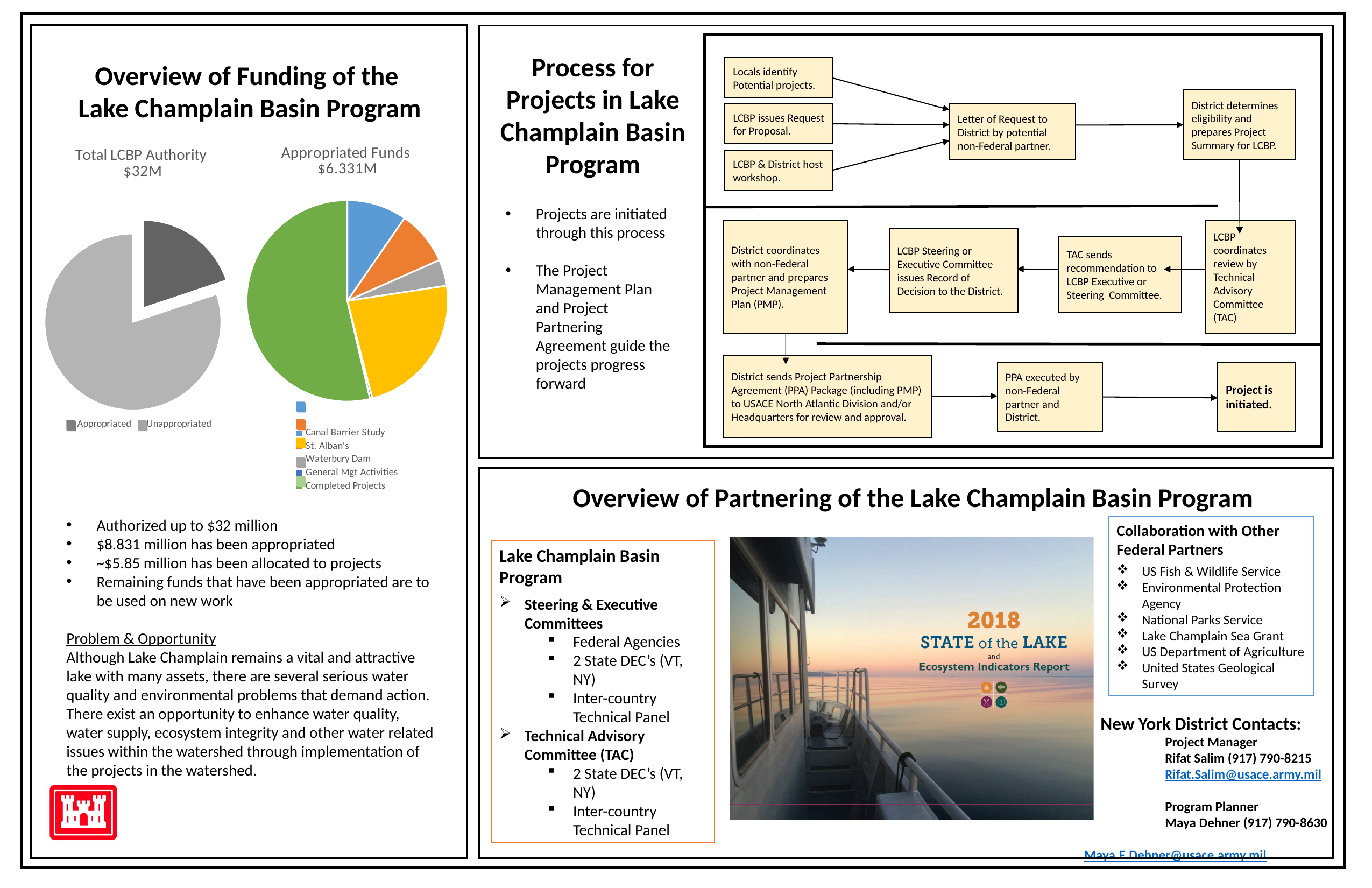
In the "Total LCBP Authority $32M" chart, which slice is larger, Appropriated or Unappropriated? Unappropriated In the "Appropriated Funds $6.331M" chart, which category has the largest slice? Completed Projects What is the title of the pie chart on the left of the funding panel? Total LCBP Authority $32M How many entries does the legend of the "Total LCBP Authority $32M" chart list? 2 In the "Total LCBP Authority $32M" chart, which category has the largest slice? Unappropriated What kind of chart is the "Total LCBP Authority $32M" chart? Pie chart In the "Total LCBP Authority $32M" chart, how many slices are there? 2 In the "Appropriated Funds $6.331M" chart, which slice is larger, Completed Projects or St. Alban's? Completed Projects What kind of chart is the "Appropriated Funds $6.331M" chart? Pie chart